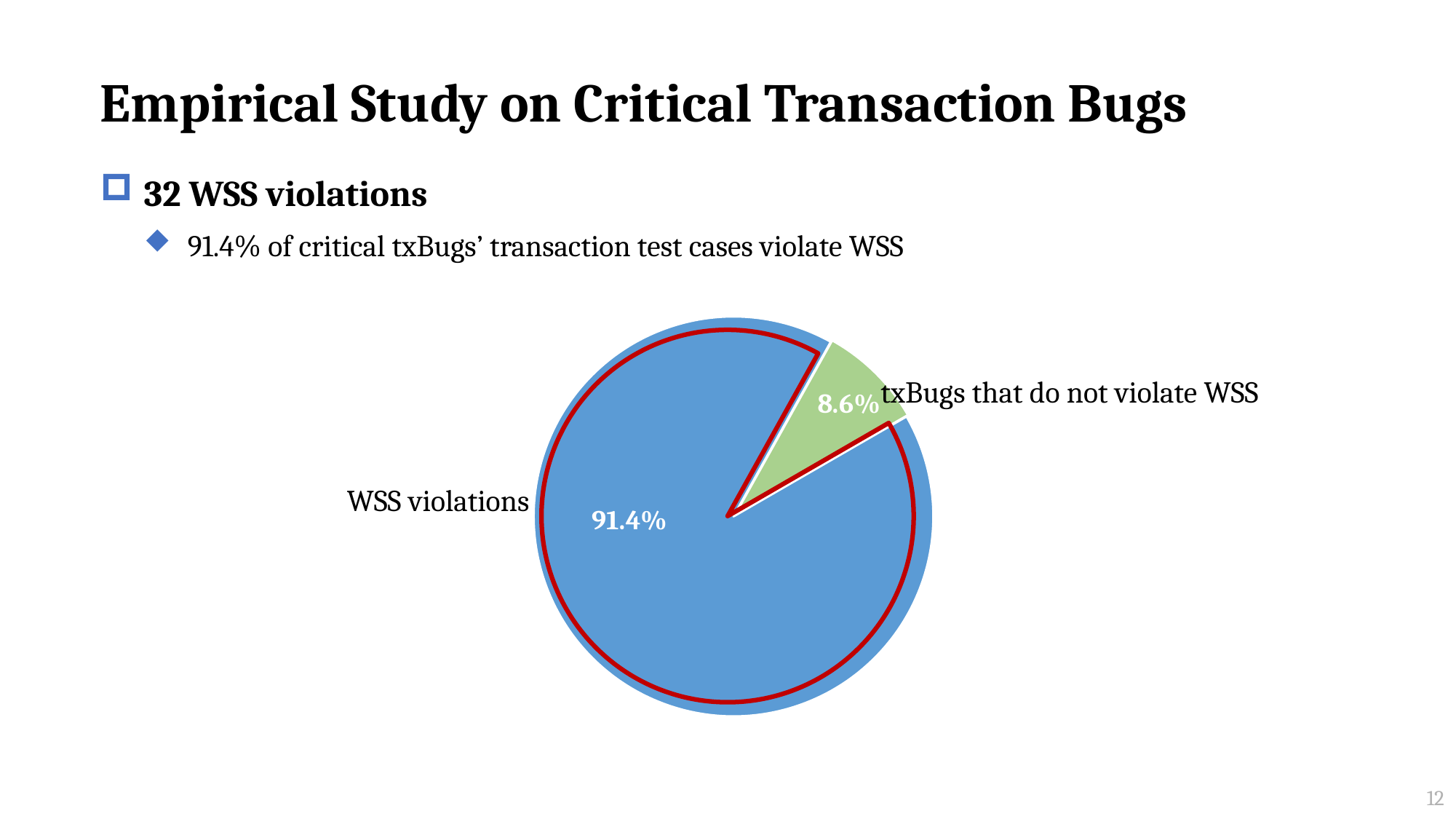
What kind of chart is shown on the slide? pie chart Which is larger: the "WSS violations" slice or the "txBugs that do not violate WSS" slice? WSS violations What colour is the "txBugs that do not violate WSS" slice? green Is the share for "WSS violations" greater or less than 50%? greater What share of the pie is labelled "WSS violations"? 91.4% How many slices does the pie chart have? 2 Which slice of the pie chart is the largest? WSS violations Which slice of the pie chart is the smallest? txBugs that do not violate WSS What is the difference in percentage points between the "WSS violations" slice and the "txBugs that do not violate WSS" slice? 82.8 What colour is the "WSS violations" slice? blue What share of the pie is labelled "txBugs that do not violate WSS"? 8.6%